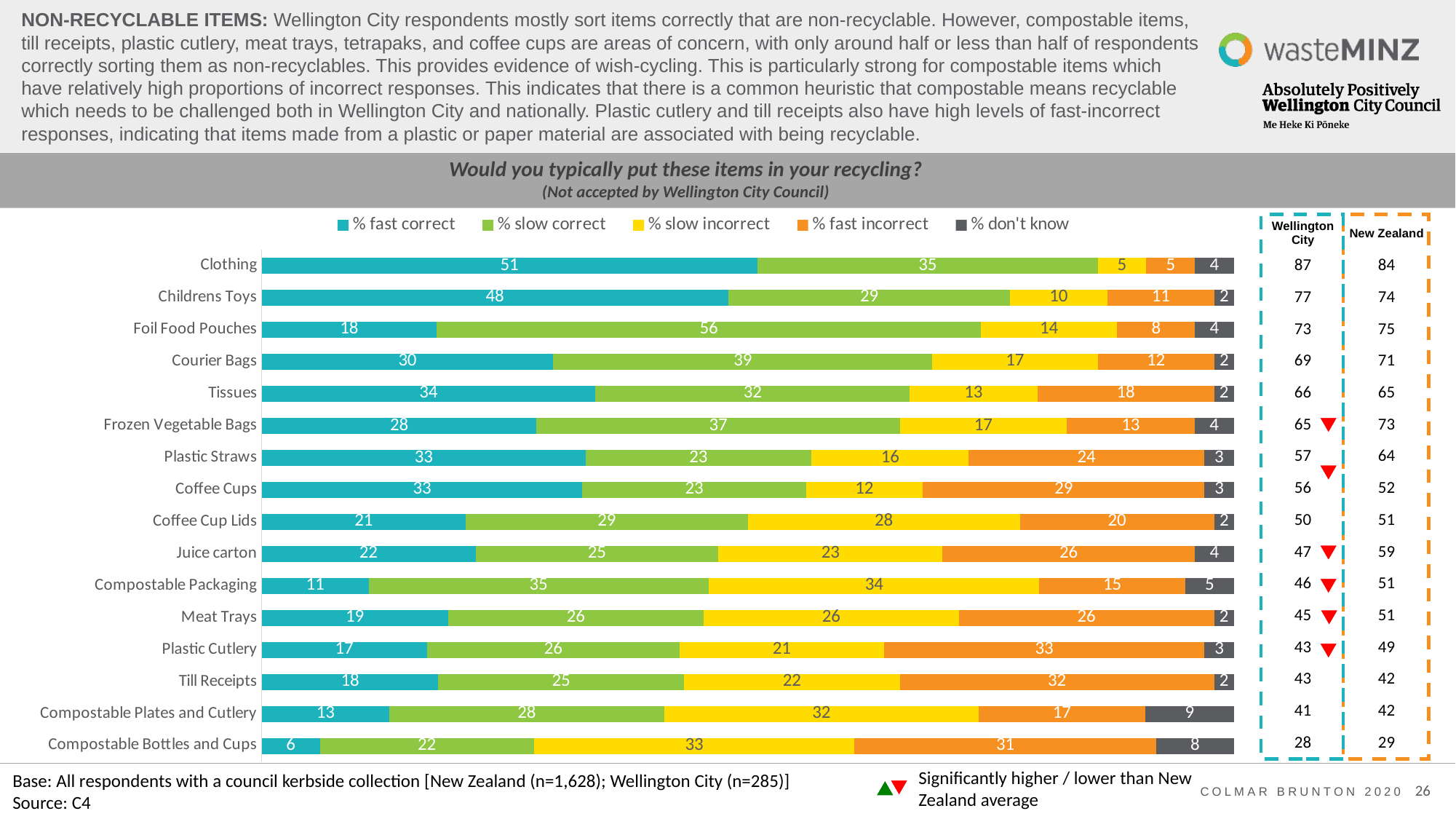
What is the % slow correct value for Foil Food Pouches? 56 What is the % fast incorrect value for Plastic Cutlery? 33 Which has the larger % fast correct value, Tissues or Courier Bags? Tissues How many items (categories) are plotted in the chart? 16 Which item has the highest % fast correct value? Clothing Which item has the lowest % fast correct value? Compostable Bottles and Cups What is the % don't know value for Compostable Plates and Cutlery? 9 What is the difference between the % fast correct values for Clothing and Childrens Toys? 3 What is the % fast correct value for Clothing? 51 How many series does the legend list? 5 What is the question shown as the chart's title? Would you typically put these items in your recycling? What kind of chart is shown on the slide? Stacked bar chart